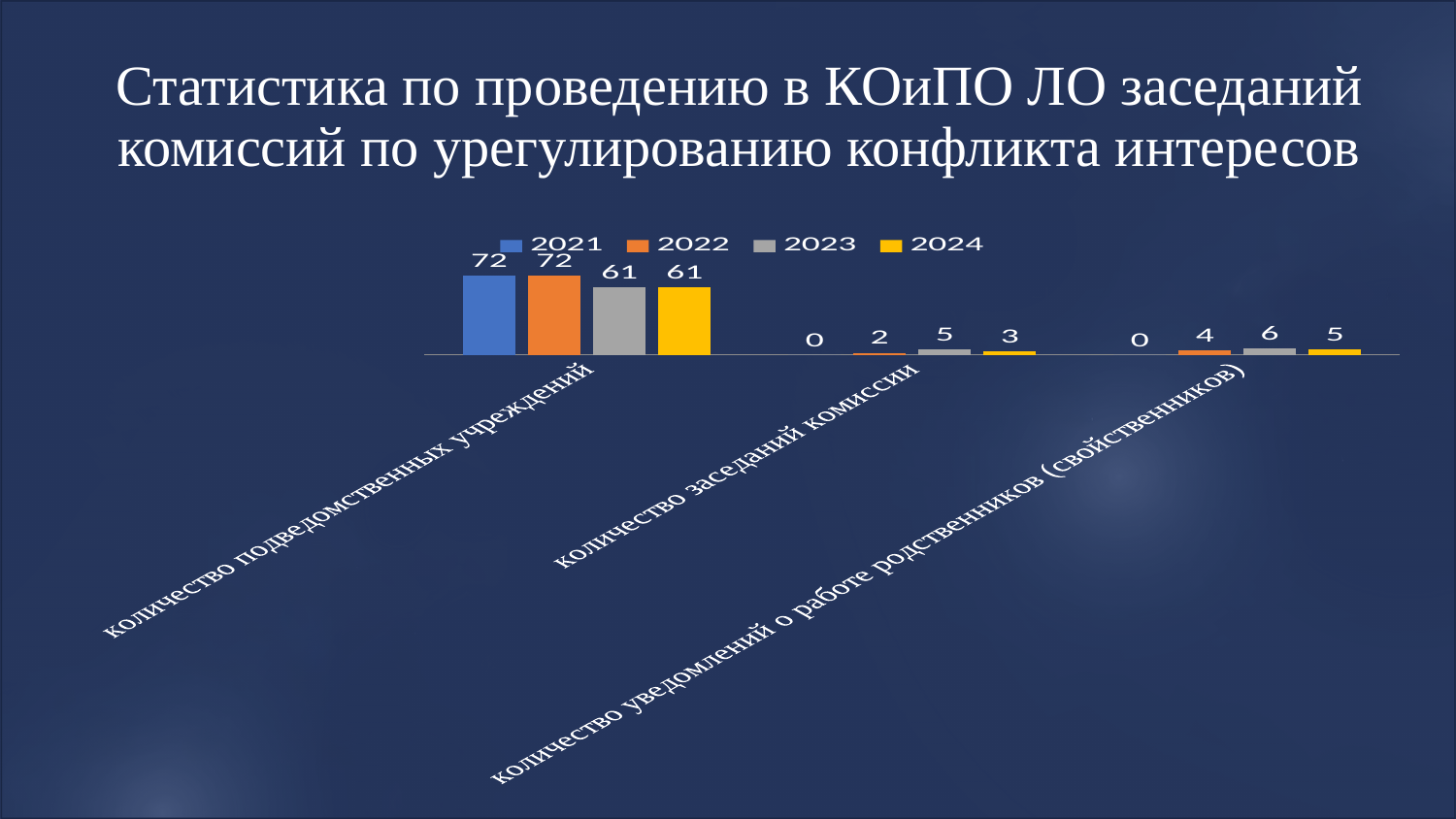
Which series is shown in yellow in the legend? 2024 Which year has the highest value in the category "количество заседаний комиссии"? 2023 What is the value for 2024 in the category "количество уведомлений о работе родственников (свойственников)"? 5 What kind of chart is shown on the slide? bar chart What is the value for 2022 in the category "количество заседаний комиссии"? 2 What is the difference between the 2021 and 2023 values in the category "количество подведомственных учреждений"? 11 What is the difference between the 2023 and 2024 values in the category "количество заседаний комиссии"? 2 In the category "количество уведомлений о работе родственников (свойственников)", which is larger: the value for 2022 or the value for 2023? 2023 What is the value for 2023 in the category "количество подведомственных учреждений"? 61 How many series does the legend list? 4 How many categories are shown on the x axis? 3 Which year has the lowest value in the category "количество уведомлений о работе родственников (свойственников)"? 2021